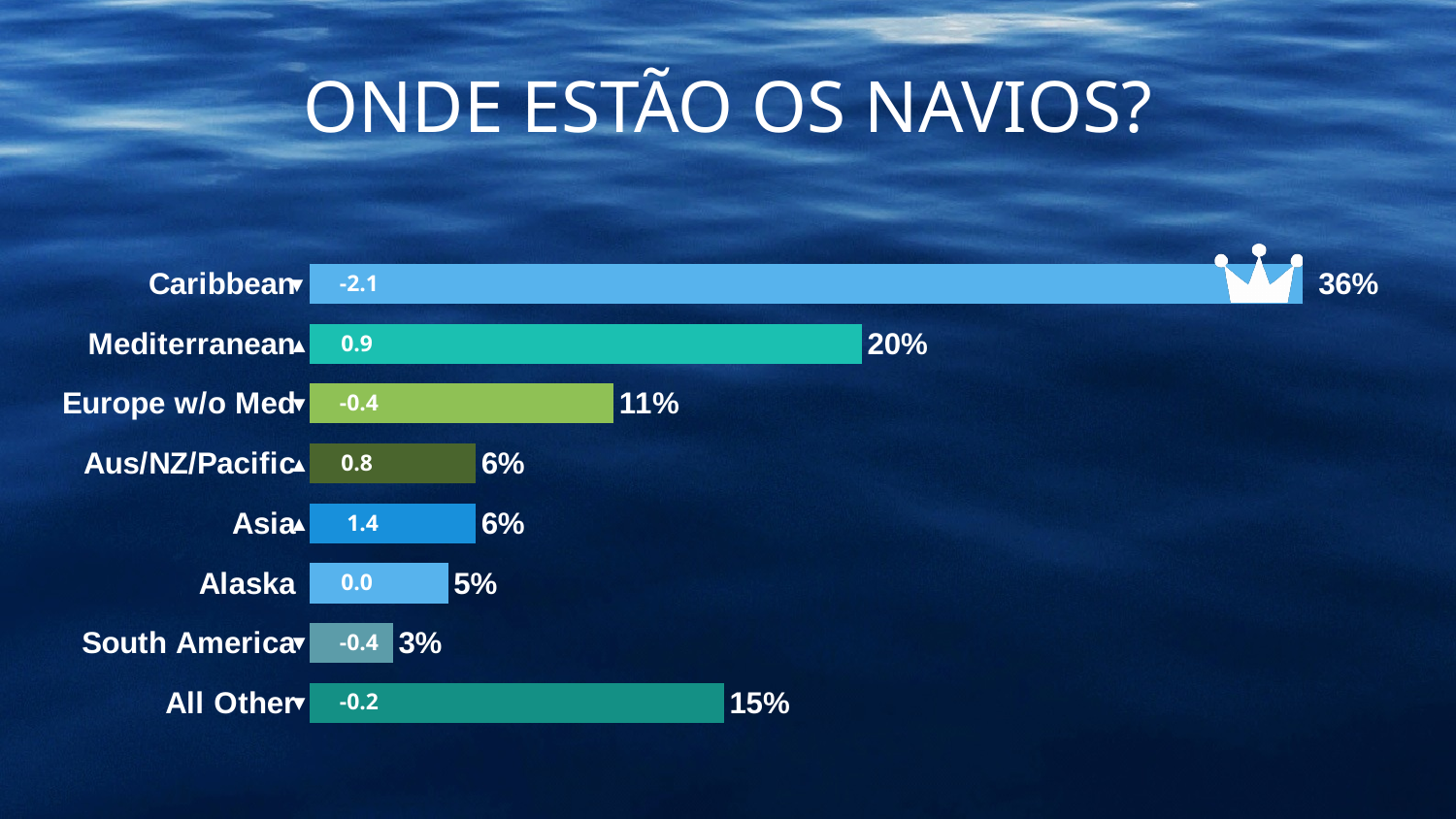
Which region has the highest share? Caribbean Which region has the lowest share? South America Which has a larger share, Europe w/o Med or All Other? All Other What is the title of the slide? ONDE ESTÃO OS NAVIOS? What share is shown for Caribbean? 36% What is the difference in share between Caribbean and Mediterranean? 16% What change value is printed inside the Asia bar? 1.4 What change value is printed inside the Caribbean bar? -2.1 What kind of chart is shown on the slide? Bar chart What share is shown for All Other? 15% What share is shown for Mediterranean? 20% How many regions are shown in the chart? 8